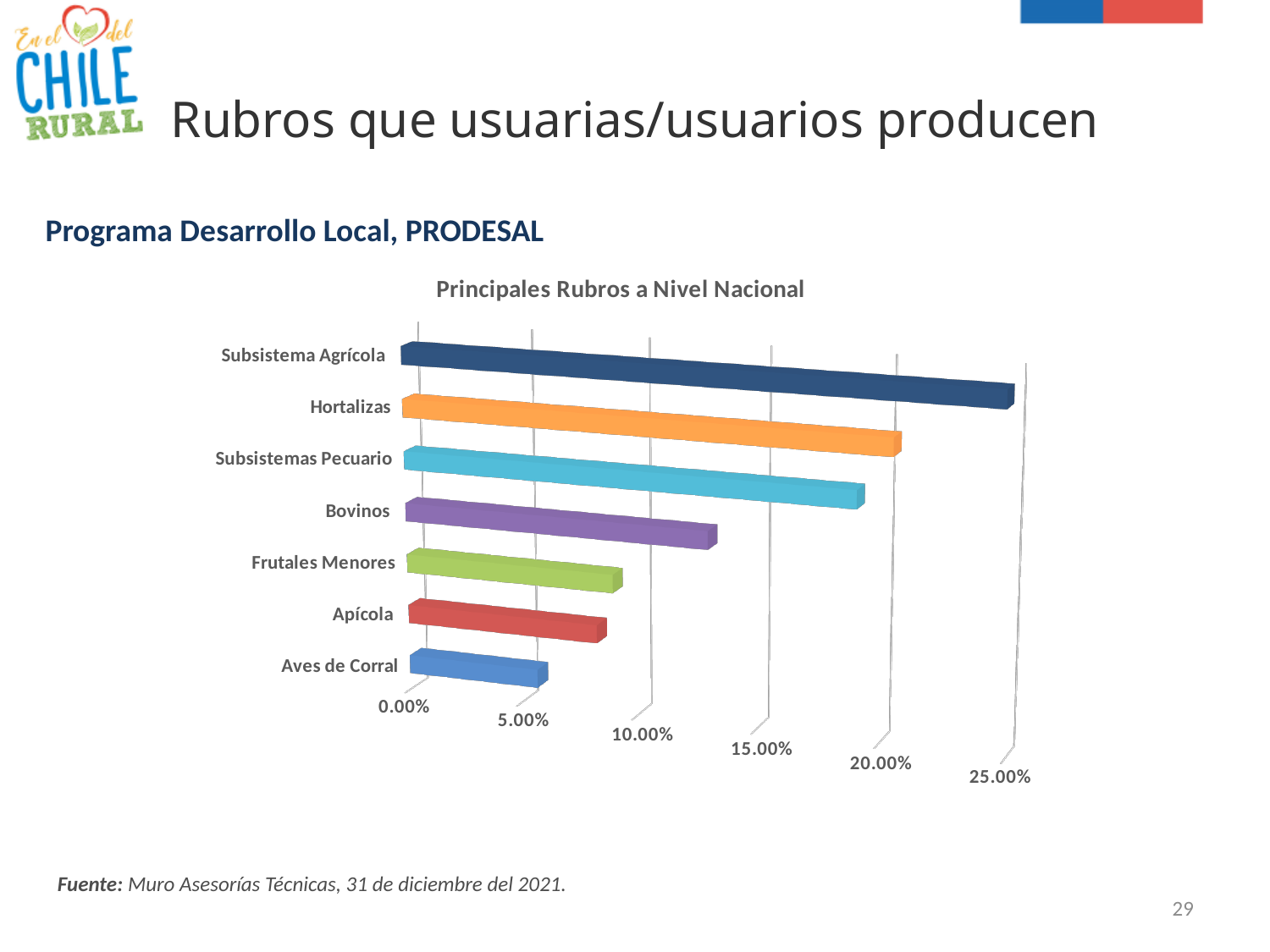
Is the value for Bovinos greater or less than 15.00%? less Which category has the highest value? Subsistema Agrícola How many categories are plotted in the chart? 7 What type of chart is shown on the slide? Bar chart What colour is the bar for Hortalizas? Orange Is the value for Apícola greater or less than 5.00%? greater What is the title of the chart? Principales Rubros a Nivel Nacional Which category has the lowest value? Aves de Corral Is the value for Frutales Menores greater or less than 10.00%? less Which is larger, the value for Hortalizas or the value for Bovinos? Hortalizas